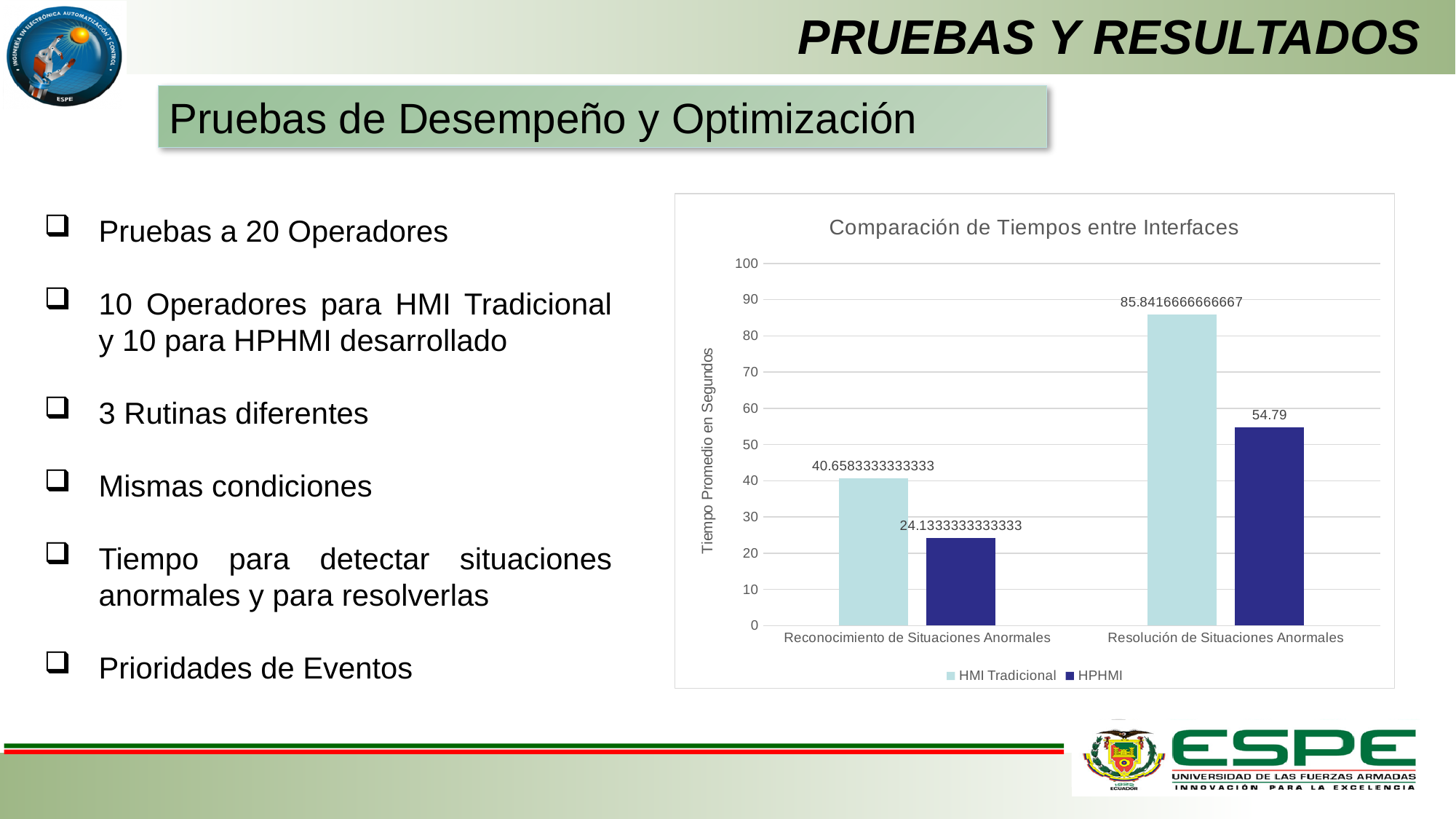
What is the value for HMI Tradicional in Reconocimiento de Situaciones Anormales? 40.6583333333333 How many categories are shown on the x axis of the chart? 2 What is the value for HPHMI in Resolución de Situaciones Anormales? 54.79 What is the value for HPHMI in Reconocimiento de Situaciones Anormales? 24.1333333333333 Which bar in the chart has the highest value? HMI Tradicional, Resolución de Situaciones Anormales Which bar in the chart has the lowest value? HPHMI, Reconocimiento de Situaciones Anormales Which series has the larger value in Resolución de Situaciones Anormales, HMI Tradicional or HPHMI? HMI Tradicional What is the value for HMI Tradicional in Resolución de Situaciones Anormales? 85.8416666666667 What is the difference between HMI Tradicional and HPHMI in Reconocimiento de Situaciones Anormales? 16.525 What type of chart is shown on the slide? bar chart What is the title of the chart? Comparación de Tiempos entre Interfaces How many series does the chart legend list? 2